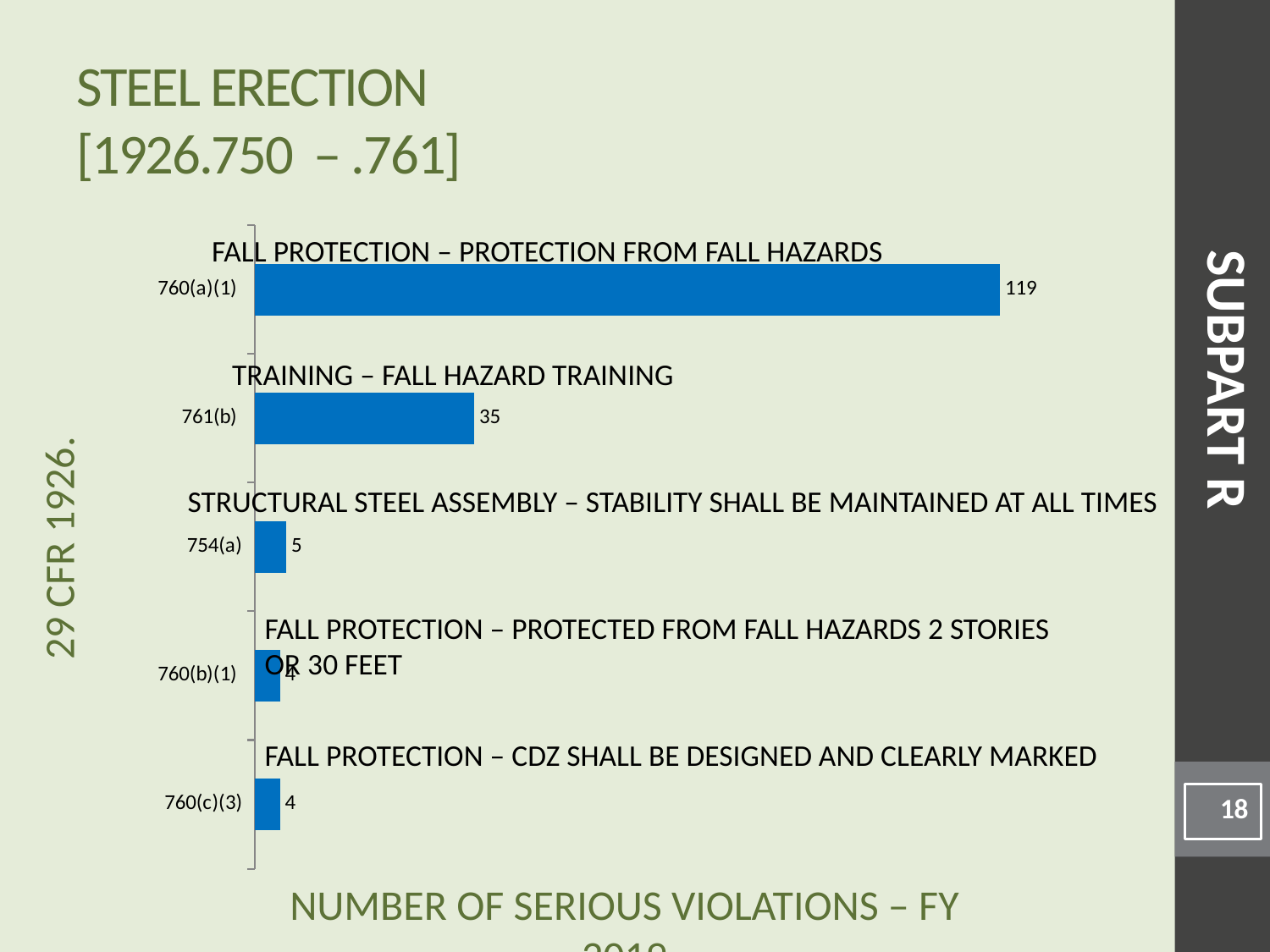
What is the number of serious violations for 760(c)(3)? 4 What is the number of serious violations for 761(b)? 35 What is the number of serious violations for 754(a)? 5 Which standard has the highest number of serious violations? 760(a)(1) What is the difference between the number of violations for 760(a)(1) and 761(b)? 84 What type of chart is shown on the slide? Bar chart What is the number of serious violations for 760(a)(1)? 119 What is the difference between the number of violations for 761(b) and 754(a)? 30 What is the difference between the number of violations for 760(a)(1) and 760(c)(3)? 115 What description is given for the 761(b) bar? TRAINING – FALL HAZARD TRAINING Which has more serious violations, 761(b) or 754(a)? 761(b) How many standards (categories) are shown in the chart? 5